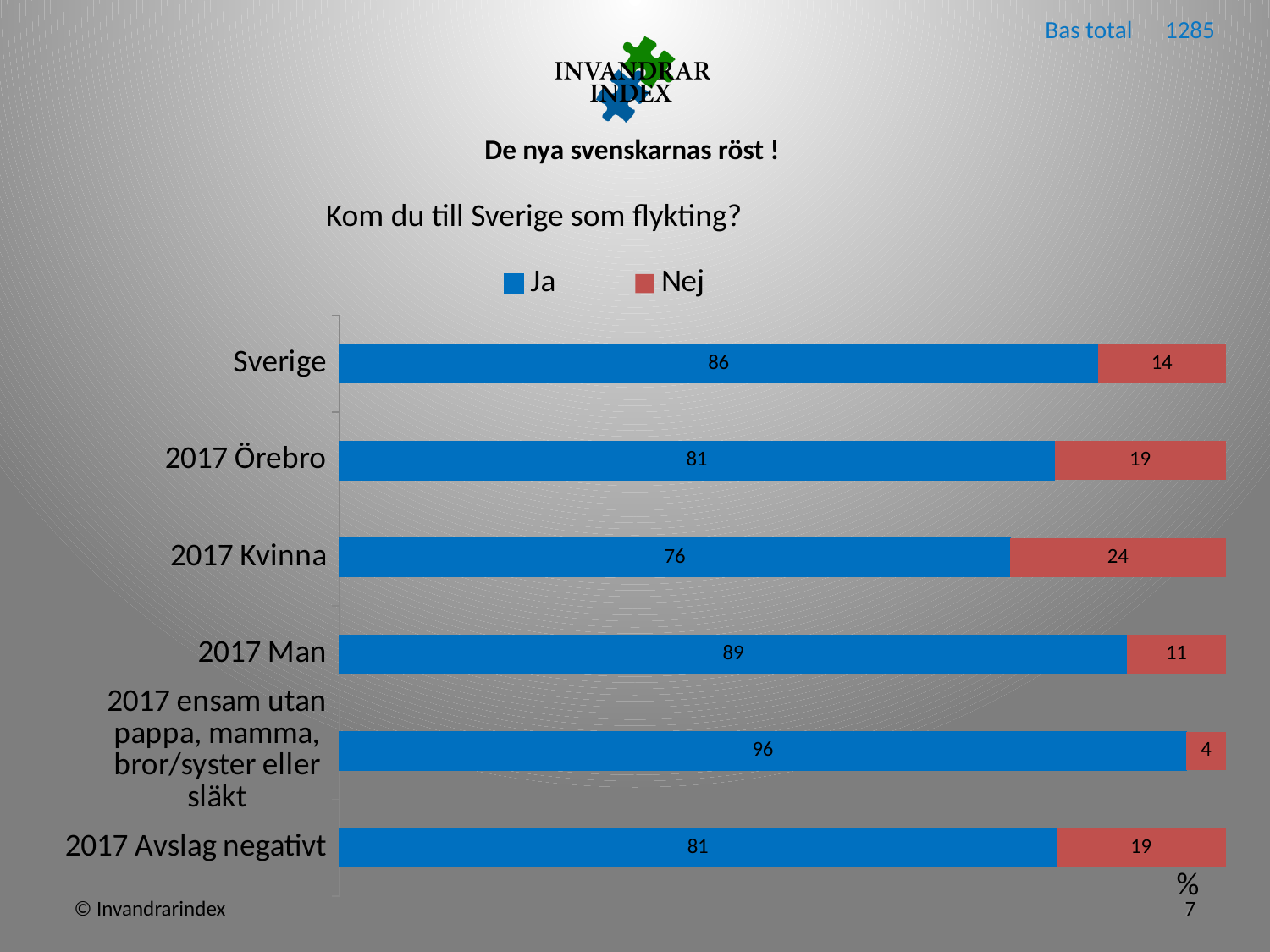
How many categories are shown in the chart? 6 What kind of chart is shown on the slide? Stacked bar chart What is the value of Nej for 2017 Avslag negativt? 19 What is the value of Ja for Sverige? 86 What is the total of the stacked bar for 2017 Man? 100 How many series does the legend list? 2 What is the value of Ja for 2017 ensam utan pappa, mamma, bror/syster eller släkt? 96 Which is larger, the Nej value for 2017 Örebro or the Nej value for Sverige? 2017 Örebro What is the difference between the Ja values for 2017 Man and 2017 Kvinna? 13 What is the value of Nej for 2017 Kvinna? 24 Which category has the highest Ja value? 2017 ensam utan pappa, mamma, bror/syster eller släkt Which category has the lowest Ja value? 2017 Kvinna